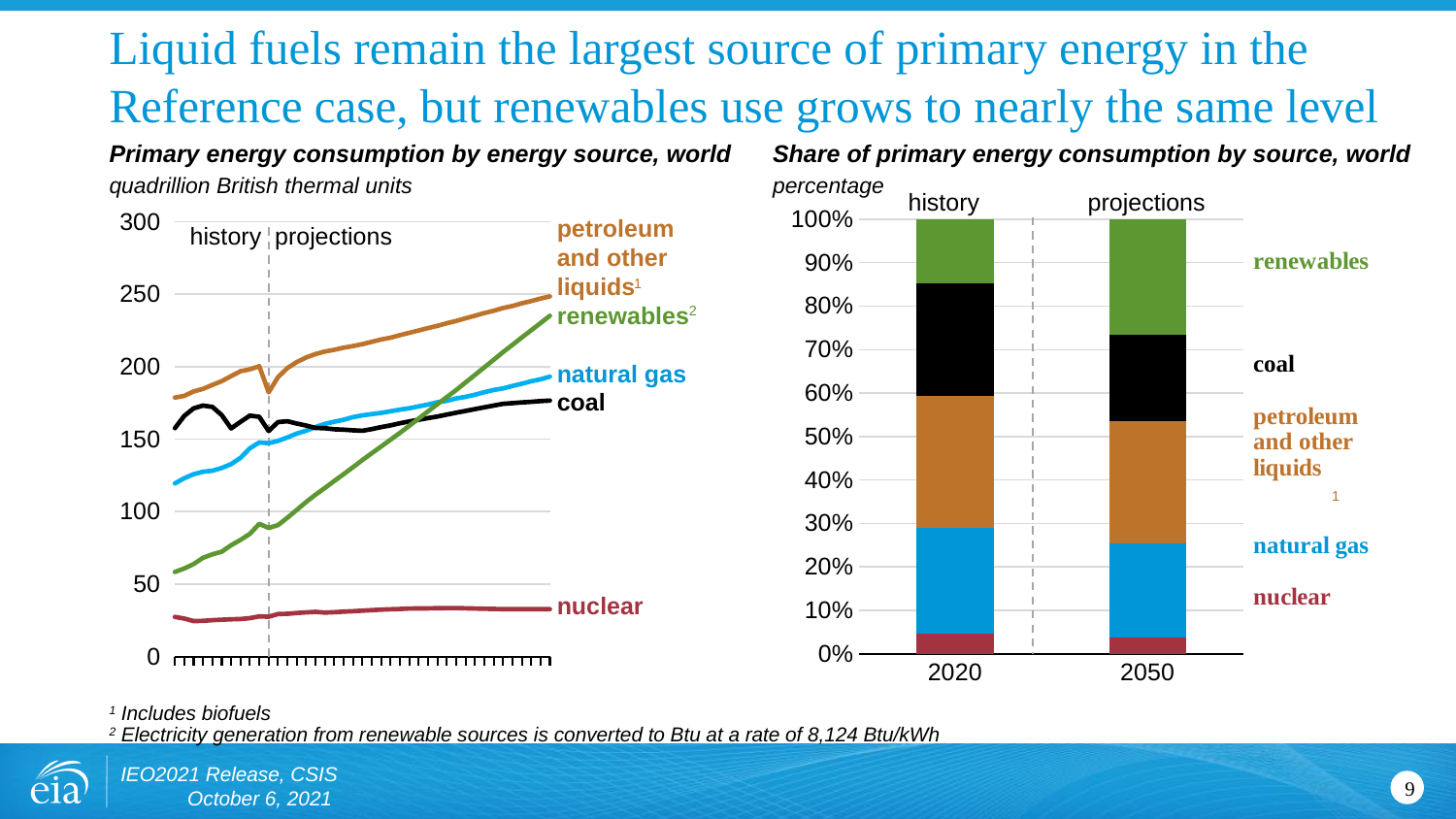
In the right chart, 'Share of primary energy consumption by source, world', is the renewables share larger in 2020 or in 2050? 2050 In the right chart, 'Share of primary energy consumption by source, world', is the coal share in 2020 greater or less than 20%? greater In the left chart, 'Primary energy consumption by energy source, world', what unit is shown under the chart title? quadrillion British thermal units In the left chart, 'Primary energy consumption by energy source, world', how many energy source series are plotted? 5 In the left chart, 'Primary energy consumption by energy source, world', is the value for nuclear at the end of the projections greater or less than 50? less In the left chart, 'Primary energy consumption by energy source, world', is the value for petroleum and other liquids at the end of the projections greater or less than 200? greater In the left chart, 'Primary energy consumption by energy source, world', does renewables consumption rise or fall over the projection period? rise What kind of chart is the right chart, 'Share of primary energy consumption by source, world'? bar chart What kind of chart is the left chart, 'Primary energy consumption by energy source, world'? line chart In the left chart, 'Primary energy consumption by energy source, world', which energy source has the lowest consumption throughout the period? nuclear In the left chart, 'Primary energy consumption by energy source, world', which energy source has the highest consumption at the end of the projection period? petroleum and other liquids In the right chart, 'Share of primary energy consumption by source, world', how many years are shown on the x axis? 2